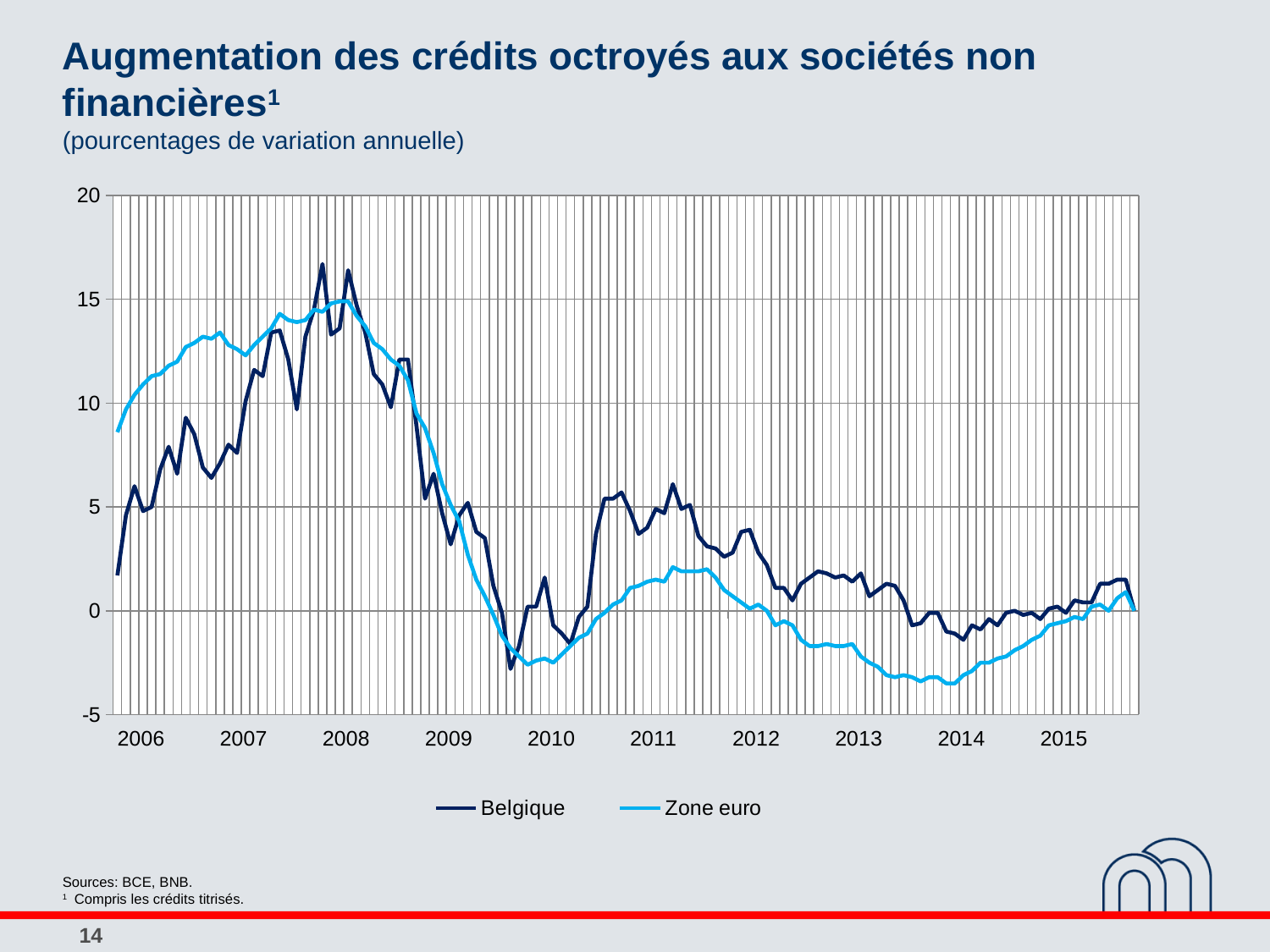
During 2007, which series has the higher values, Belgique or Zone euro? Zone euro How many series does the legend list? 2 What kind of chart is shown on the slide? line chart Is the lowest value of the Zone euro series around 2014 greater or less than 0? less Is the peak value of the Belgique series around 2008 greater or less than 15? greater Is the value of the Zone euro series at the start of 2006 greater or less than 10? less What are the two series named in the legend? Belgique and Zone euro During 2011, which series has the higher values, Belgique or Zone euro? Belgique How many year labels are shown on the x axis? 10 Does the Zone euro series rise or fall between 2008 and 2009? fall In what unit are the values expressed, according to the subtitle? pourcentages de variation annuelle